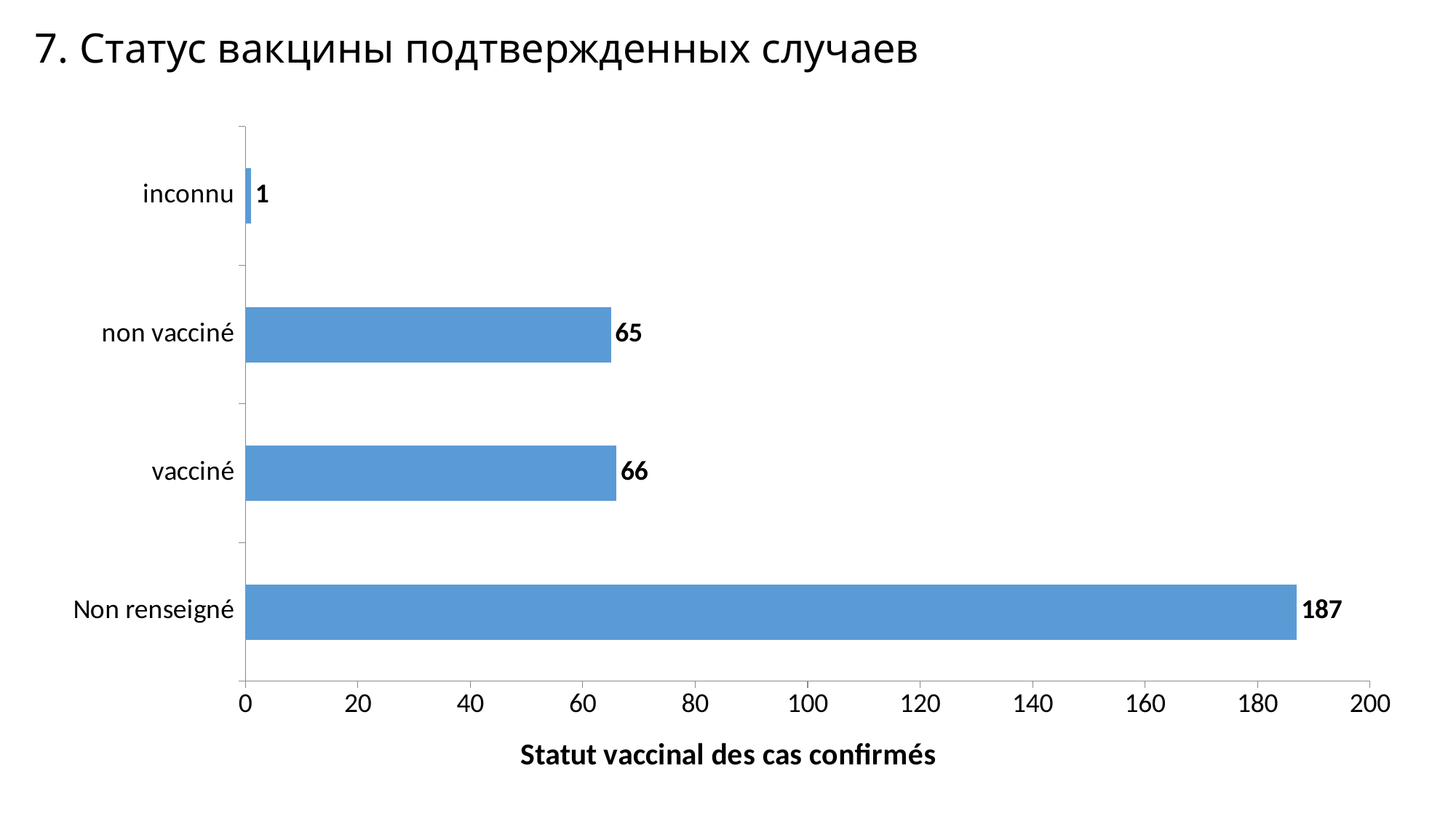
What kind of chart is shown on the slide? Bar chart What is the difference between the values for vacciné and non vacciné? 1 Which is larger, the value for Non renseigné or the value for non vacciné? Non renseigné What is the value for inconnu? 1 What is the difference between the values for Non renseigné and vacciné? 121 What is the value for non vacciné? 65 What is the value for Non renseigné? 187 How many categories are shown in the chart? 4 What is the value for vacciné? 66 Which category has the lowest value? inconnu Which category has the highest value? Non renseigné What is the axis title shown below the chart? Statut vaccinal des cas confirmés